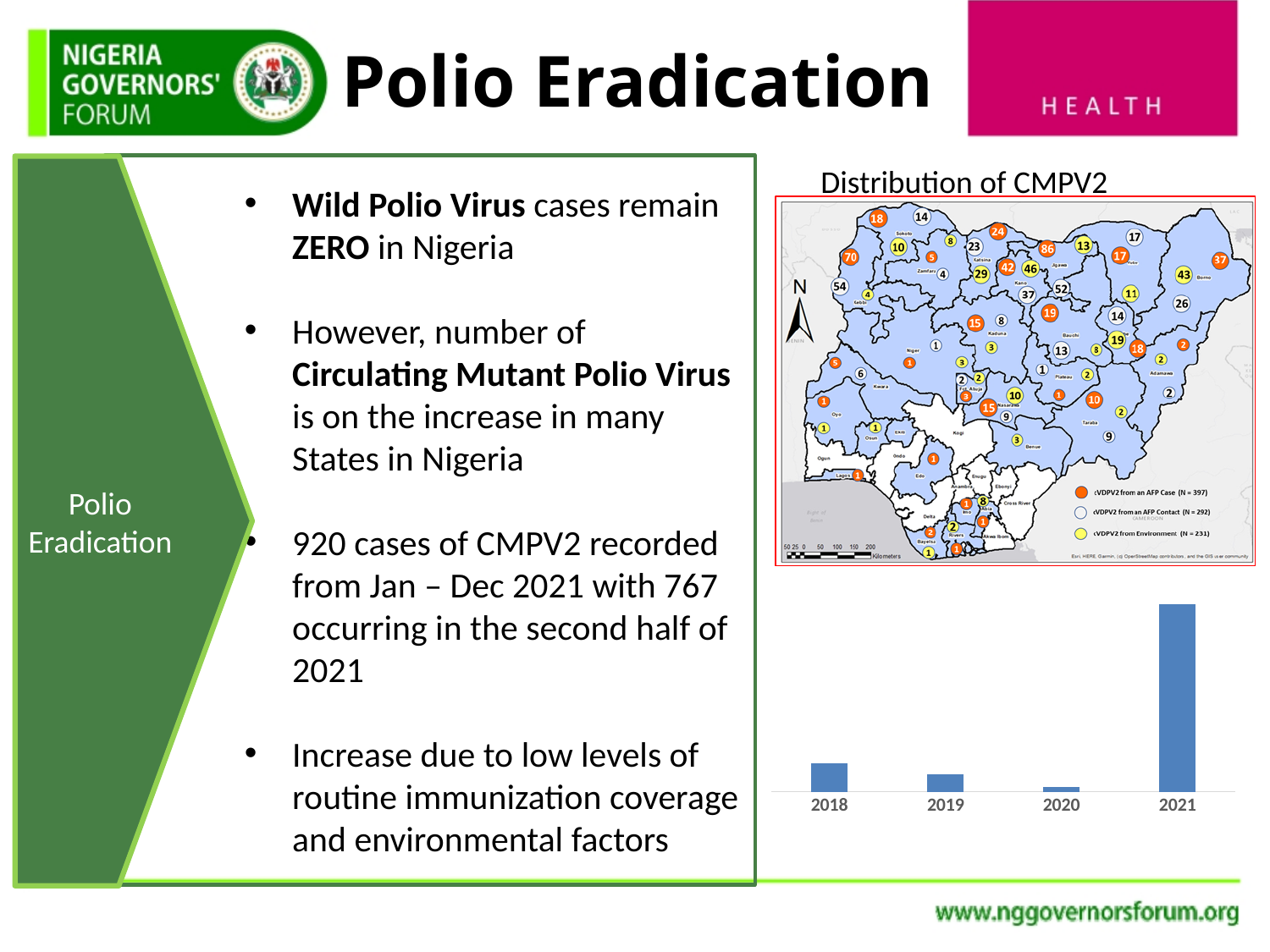
In the bar chart at the bottom right, which year has the lowest bar? 2020 What kind of chart is shown at the bottom right of the slide? bar chart In the bar chart at the bottom right, do the values rise or fall from 2018 to 2020? fall What is the title of the map shown above the bar chart? Distribution of CMPV2 In the bar chart at the bottom right, which year is the first category on the x axis? 2018 In the bar chart at the bottom right, which year has the larger value, 2019 or 2020? 2019 In the bar chart at the bottom right, which year has the larger value, 2018 or 2019? 2018 In the bar chart at the bottom right, does the value rise or fall from 2020 to 2021? rise In the bar chart at the bottom right, how many years are shown on the x axis? 4 In the bar chart at the bottom right, which year has the highest bar? 2021